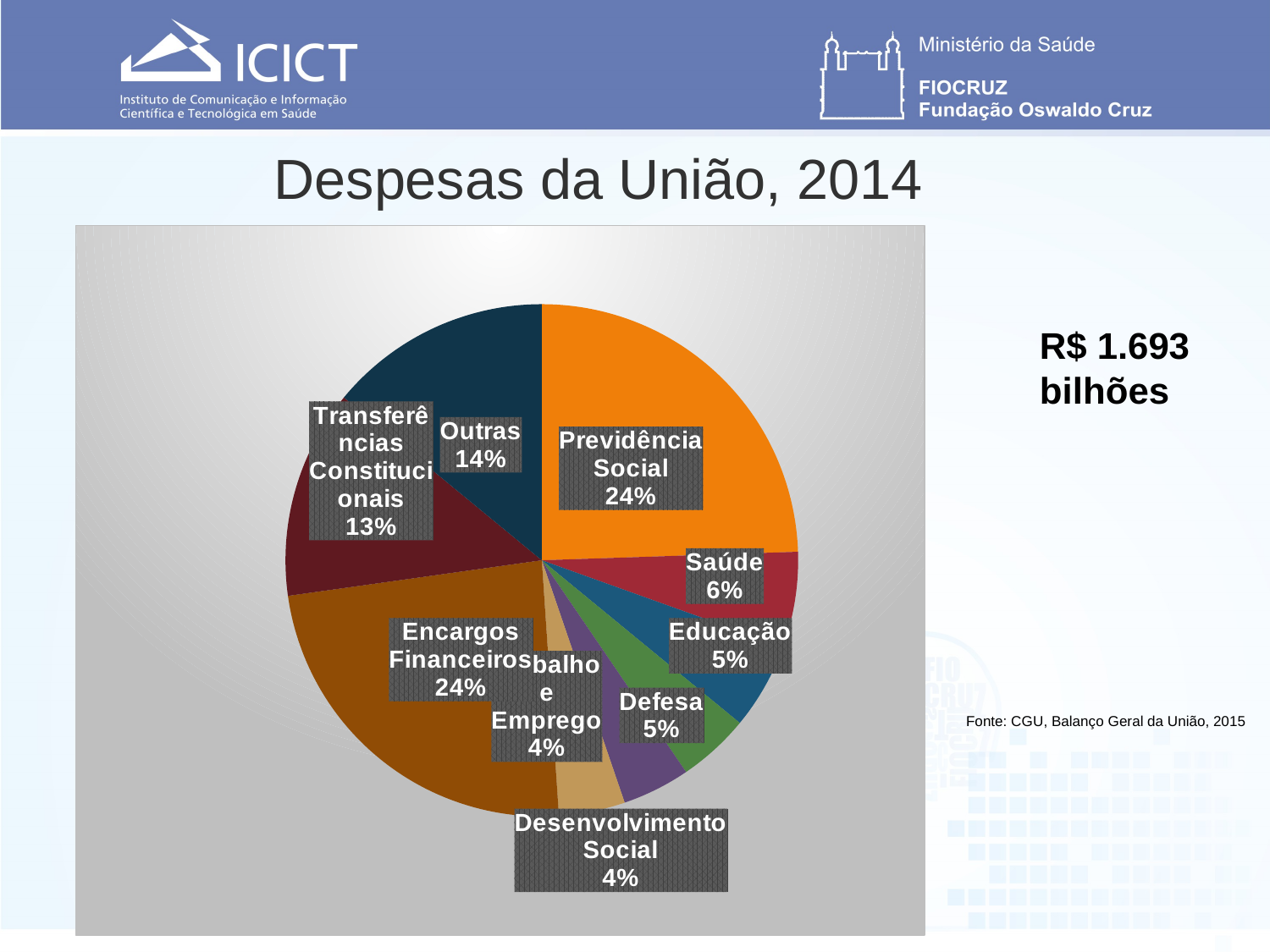
How many slices does the pie chart have? 9 What percentage is shown for Encargos Financeiros? 24% What percentage is shown for Saúde? 6% Which is larger, Outras or Transferências Constitucionais? Outras What is the difference in percentage points between Saúde and Educação? 1 percentage point What percentage is shown for Desenvolvimento Social? 4% What percentage is shown for Outras? 14% What share of the pie does Previdência Social represent? 24% What kind of chart is shown on the slide? Pie chart What total amount is shown next to the chart? R$ 1.693 bilhões What percentage is shown for Educação? 5% What percentage is shown for Transferências Constitucionais? 13%